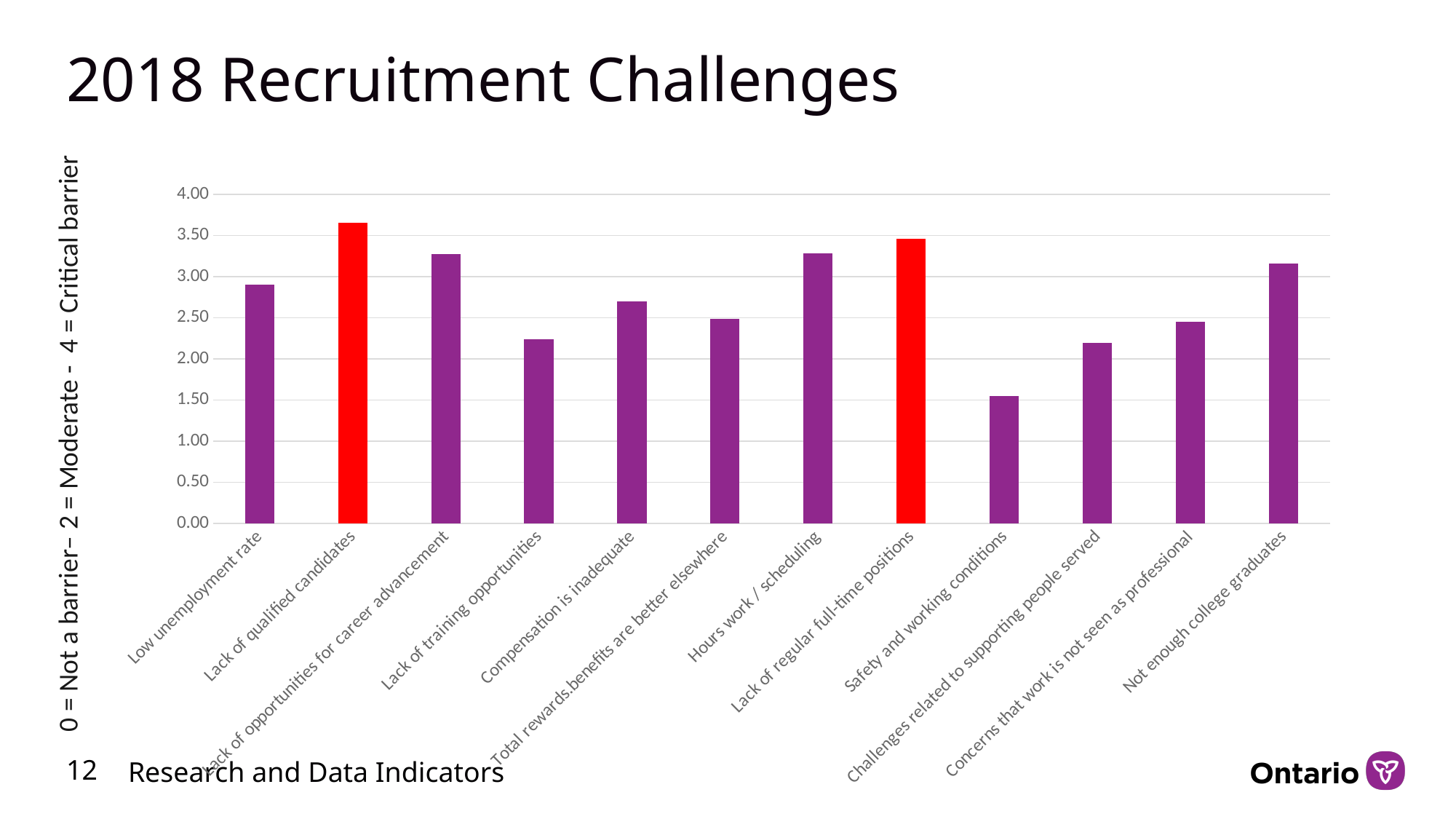
Is the value for Hours work / scheduling greater or less than 3.00? greater Which recruitment challenge has the lowest bar? Safety and working conditions How many recruitment challenge categories are plotted on the chart? 12 Which recruitment challenge has the highest bar? Lack of qualified candidates Is the value for Not enough college graduates greater or less than 3.00? greater What kind of chart is shown on the slide? Bar chart Which is larger: the value for Lack of qualified candidates or the value for Lack of regular full-time positions? Lack of qualified candidates Is the value for Compensation is inadequate greater or less than 2.50? greater How many bars on the chart are coloured red? 2 Which is larger: the value for Safety and working conditions or the value for Challenges related to supporting people served? Challenges related to supporting people served